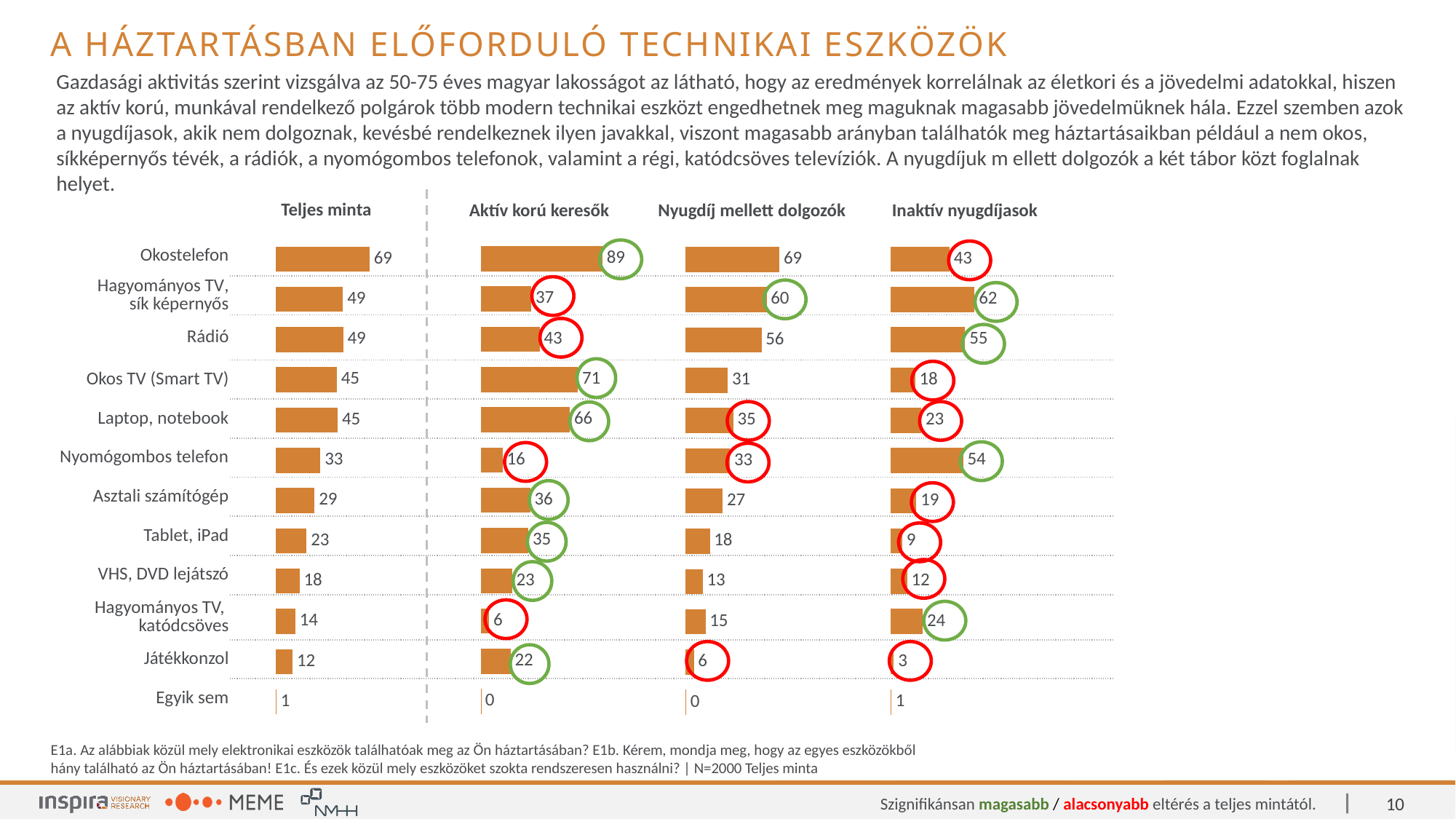
In the 'Aktív korú keresők' chart, what is the value for Okos TV (Smart TV)? 71 In the 'Aktív korú keresők' chart, what is the difference between Laptop, notebook and Tablet, iPad? 31 In the 'Nyugdíj mellett dolgozók' chart, what is the value for Rádió? 56 In the 'Inaktív nyugdíjasok' chart, which category has the highest value? Hagyományos TV, sík képernyős In the 'Teljes minta' chart, what is the value for Okostelefon? 69 What is the difference between the Okostelefon values in the 'Aktív korú keresők' chart and the 'Inaktív nyugdíjasok' chart? 46 In the 'Inaktív nyugdíjasok' chart, what is the value for Nyomógombos telefon? 54 How many group charts are shown to the right of the dashed line? 3 In the 'Nyugdíj mellett dolgozók' chart, which is larger: Laptop, notebook or Okos TV (Smart TV)? Laptop, notebook How many categories are listed in the 'Teljes minta' chart? 12 What kind of chart is used in the 'Teljes minta' column? Bar chart In the 'Aktív korú keresők' chart, which category has the lowest value? Egyik sem